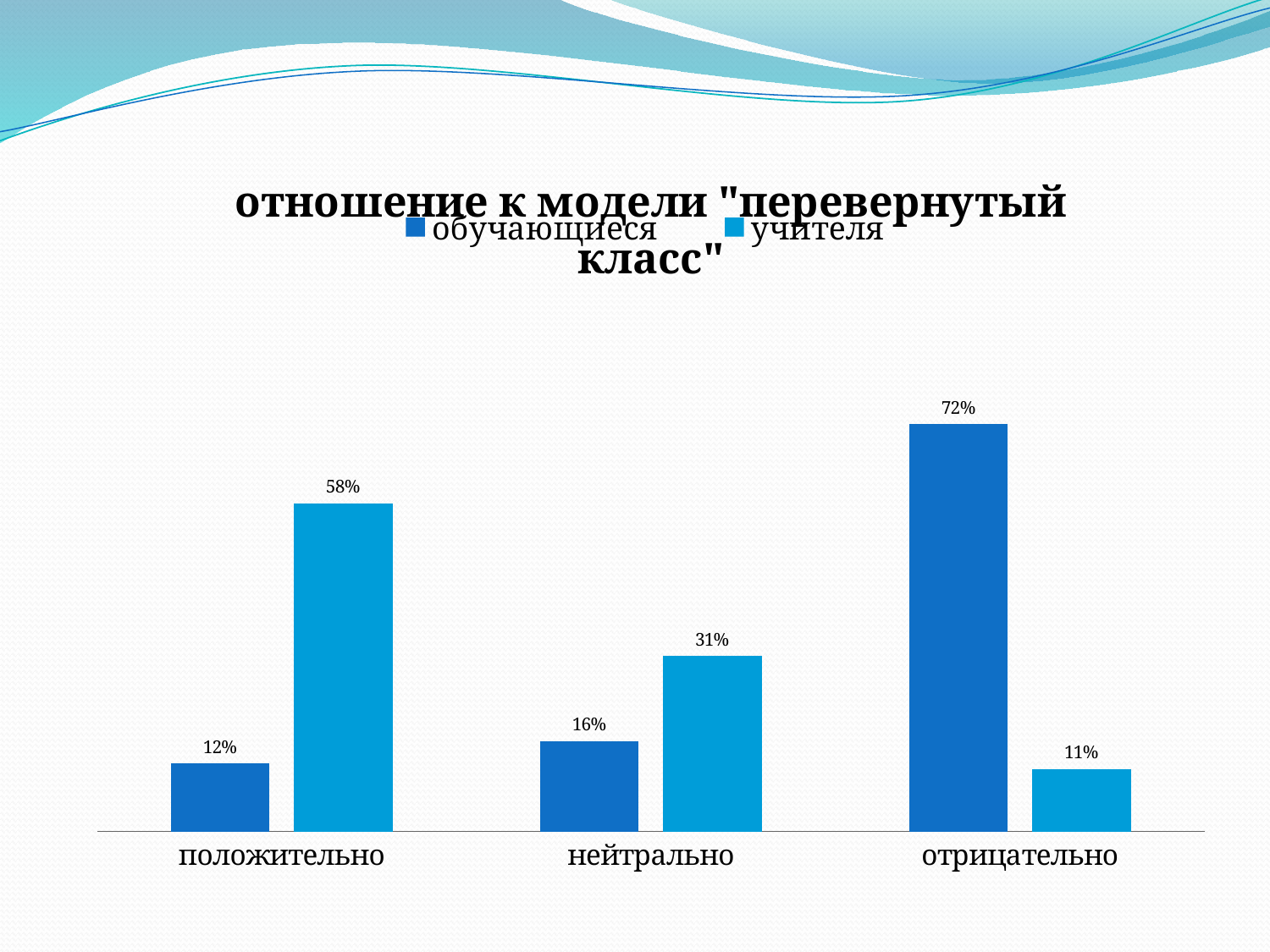
What is the difference between the учителя and обучающиеся values in the положительно category? 46% How many categories are shown on the x axis? 3 Which is larger in the нейтрально category: обучающиеся or учителя? учителя What is the value for учителя in the отрицательно category? 11% What is the value for обучающиеся in the положительно category? 12% In which category is the value for обучающиеся highest? отрицательно What is the value for учителя in the положительно category? 58% What type of chart is shown on the slide? bar chart In which category is the value for учителя lowest? отрицательно What is the value for обучающиеся in the нейтрально category? 16% How many series does the legend list? 2 What is the title of the chart? отношение к модели "перевернутый класс"